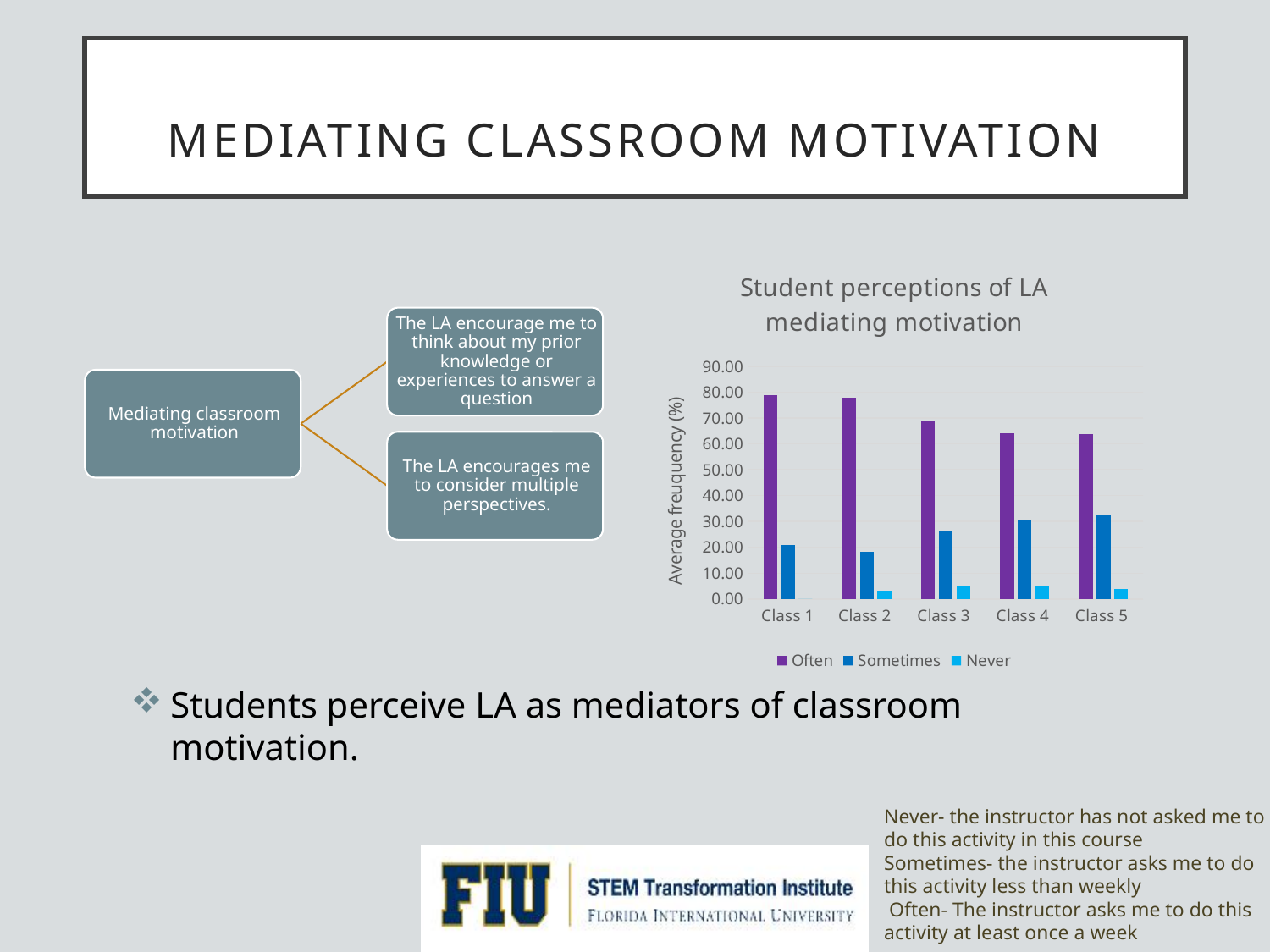
Do the Often values generally rise or fall from Class 1 to Class 5? fall Is the Often value for Class 1 greater or less than 70.00? greater How many series does the chart's legend list? 3 Is the Often value for Class 4 greater or less than 70.00? less Is the Never value for Class 3 greater or less than 10.00? less What is the label on the chart's y axis? Average freuquency (%) Which is larger, the Sometimes value for Class 4 or the Sometimes value for Class 2? Class 4 Which is larger, the Often value for Class 1 or the Often value for Class 3? Class 1 How many classes are shown on the x axis of the chart? 5 What kind of chart is shown on the slide? bar chart What is the title of the chart? Student perceptions of LA mediating motivation